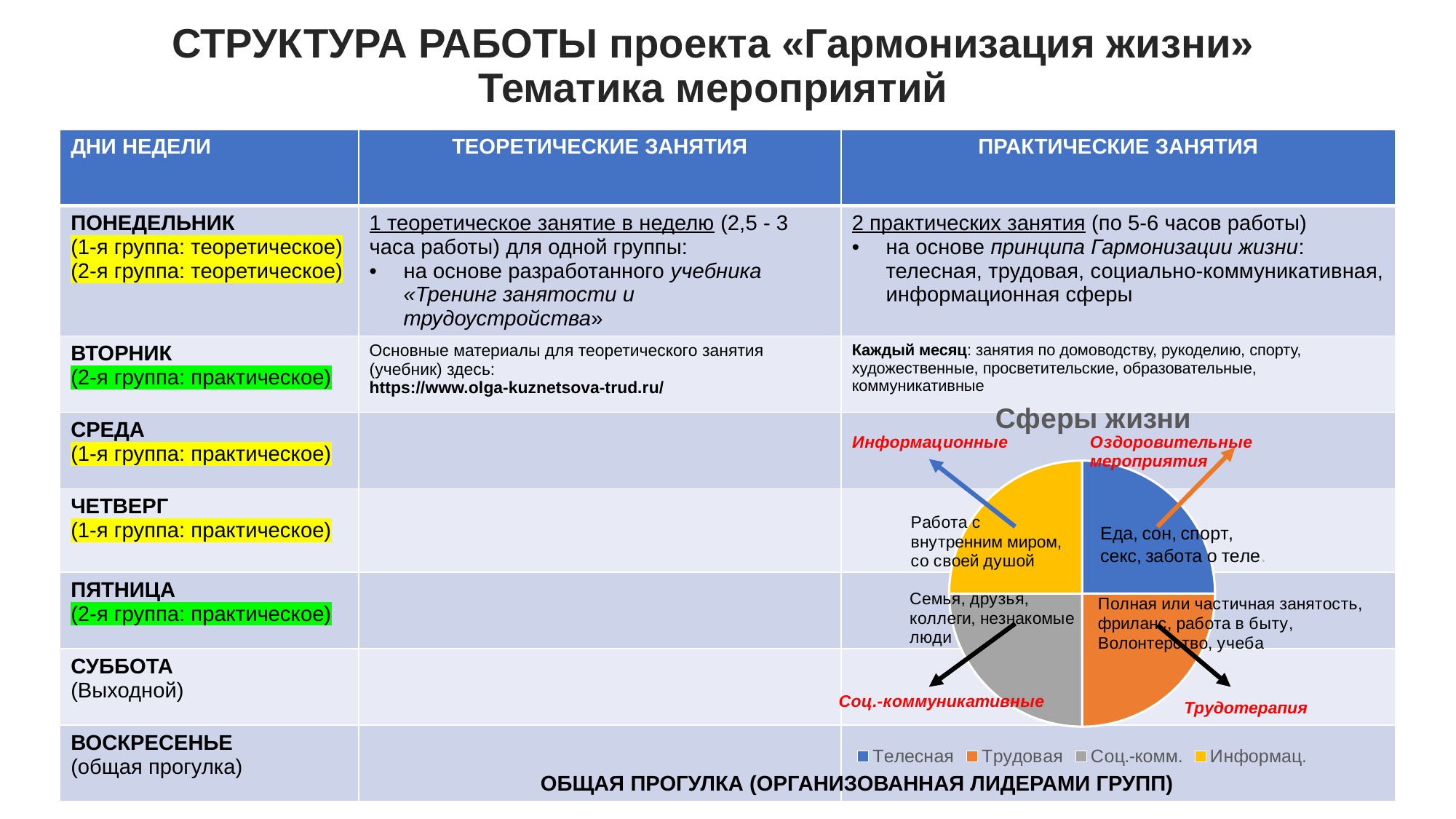
What is the title of the pie chart on the slide? Сферы жизни How many entries does the legend of the pie chart list? 4 What kind of chart is shown on the slide? pie chart Which legend entry of the pie chart is shown in yellow? Информац. How many slices does the pie chart have? 4 Which legend entry of the pie chart is shown in gray? Соц.-комм. Which colour represents the Телесная slice in the pie chart? blue Which legend entry of the pie chart is shown in orange? Трудовая